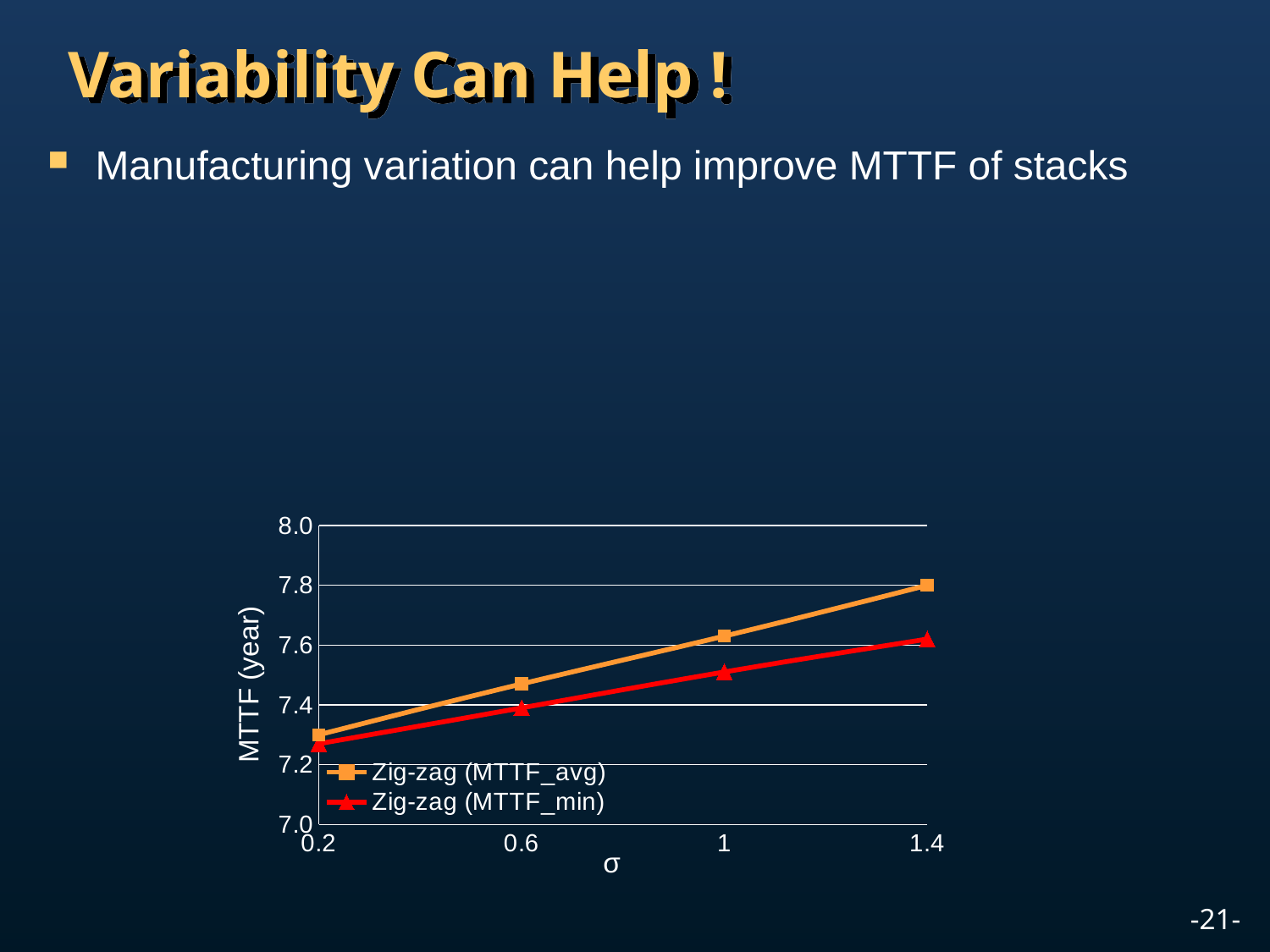
Is the Zig-zag (MTTF_avg) value at σ = 0.2 greater or less than 7.4? less At σ = 1, which series has the higher MTTF, Zig-zag (MTTF_avg) or Zig-zag (MTTF_min)? Zig-zag (MTTF_avg) How many series does the chart legend list? 2 Is the Zig-zag (MTTF_min) value at σ = 1 greater or less than 7.6? less What is the label of the y axis? MTTF (year) How many σ values are plotted along the x axis? 4 At which σ value is Zig-zag (MTTF_min) lowest? 0.2 Does the Zig-zag (MTTF_avg) series rise or fall as σ increases? rises What kind of chart is shown on the slide? line chart Does the Zig-zag (MTTF_min) series rise or fall as σ increases? rises At which σ value is Zig-zag (MTTF_avg) highest? 1.4 Is the Zig-zag (MTTF_avg) value at σ = 0.6 greater or less than 7.4? greater